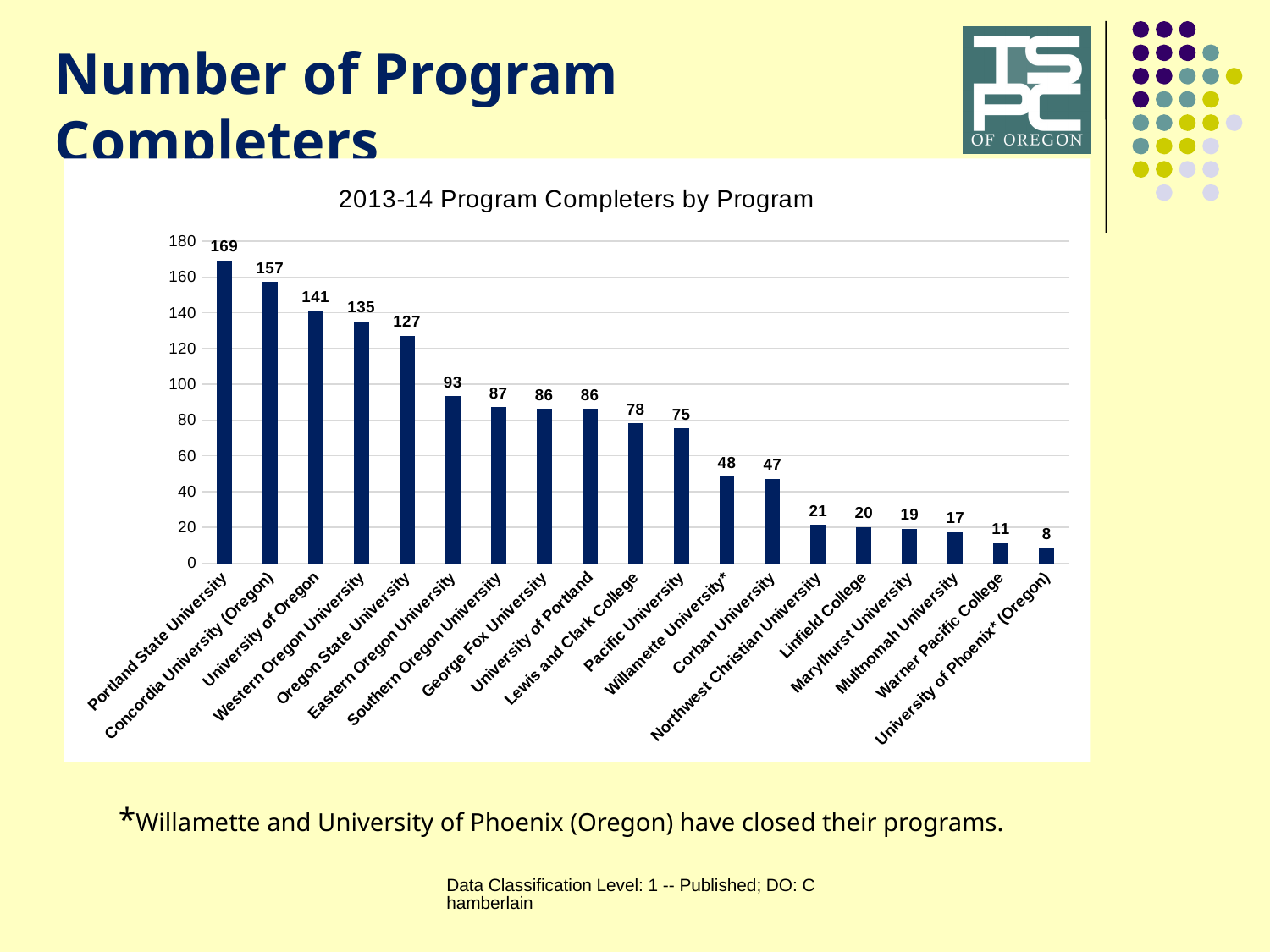
What kind of chart is shown on the slide? Bar chart Is the value for Oregon State University greater or less than 120? greater What is the difference between Concordia University (Oregon) and University of Oregon? 16 What is the title of the chart? 2013-14 Program Completers by Program What is the value for Corban University? 47 How many program completers does Eastern Oregon University show? 93 What is the value for Portland State University? 169 Which program has the lowest number of completers? University of Phoenix* (Oregon) What is the difference between Willamette University* and Warner Pacific College? 37 Which is larger, Lewis and Clark College or Pacific University? Lewis and Clark College How many programs are shown on the chart? 19 Which program has the highest number of completers? Portland State University